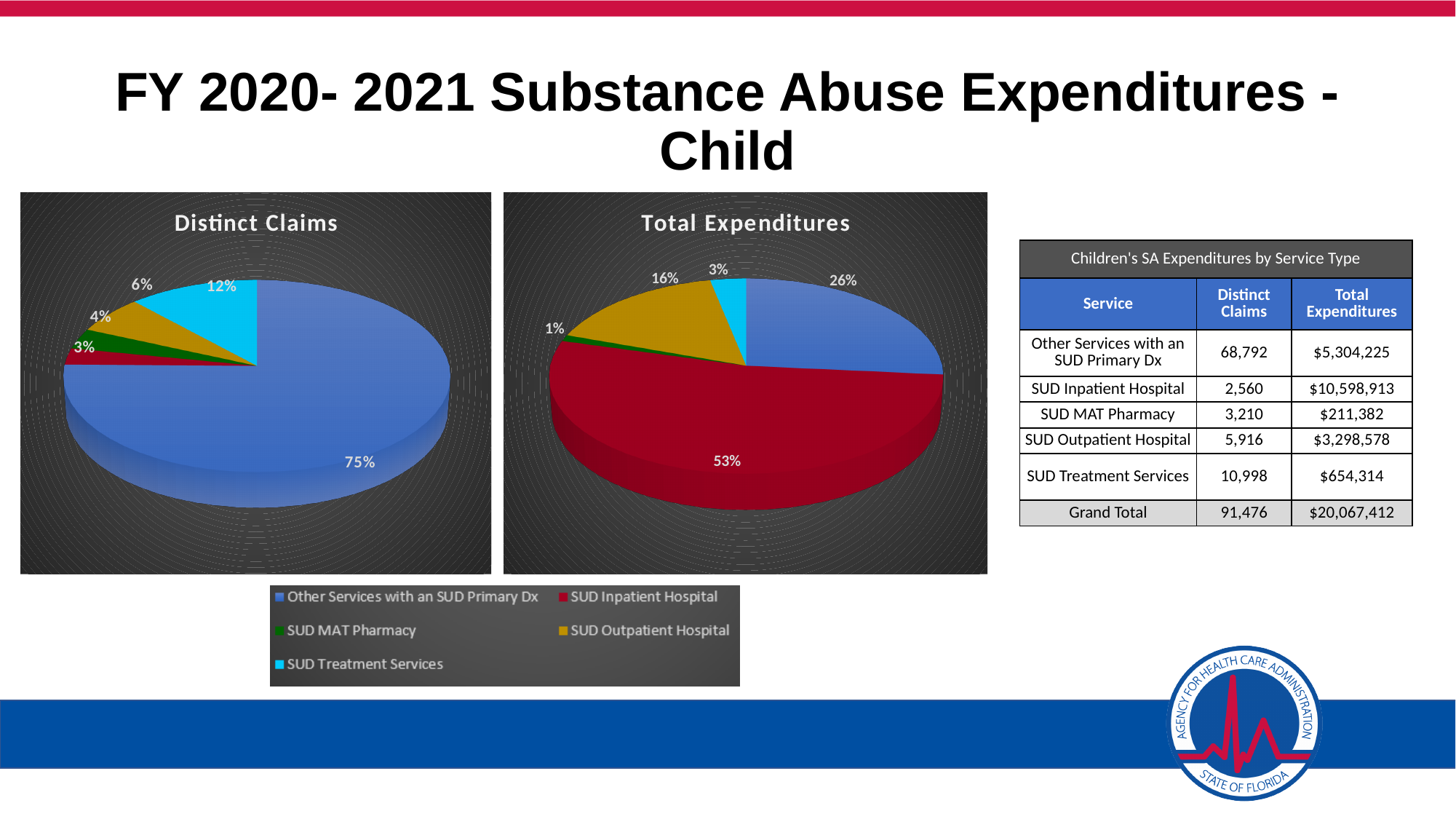
In the Distinct Claims chart, what share of the pie is SUD Treatment Services? 12% What kind of chart is the Distinct Claims chart? Pie chart In the Total Expenditures chart, which category has the largest slice? SUD Inpatient Hospital In the Total Expenditures chart, what share of the pie is SUD Outpatient Hospital? 16% In the Distinct Claims chart, which is larger: the slice for SUD Treatment Services or the slice for SUD Outpatient Hospital? SUD Treatment Services In the Distinct Claims chart, which category has the largest slice? Other Services with an SUD Primary Dx In the Total Expenditures chart, what share of the pie is SUD Inpatient Hospital? 53% What colour represents SUD Outpatient Hospital in the pie charts? Gold In the Total Expenditures chart, what is the difference in percentage points between the SUD Inpatient Hospital slice and the Other Services with an SUD Primary Dx slice? 27 How many categories does the shared legend list for the two pie charts? 5 In the Total Expenditures chart, which category has the smallest slice? SUD MAT Pharmacy